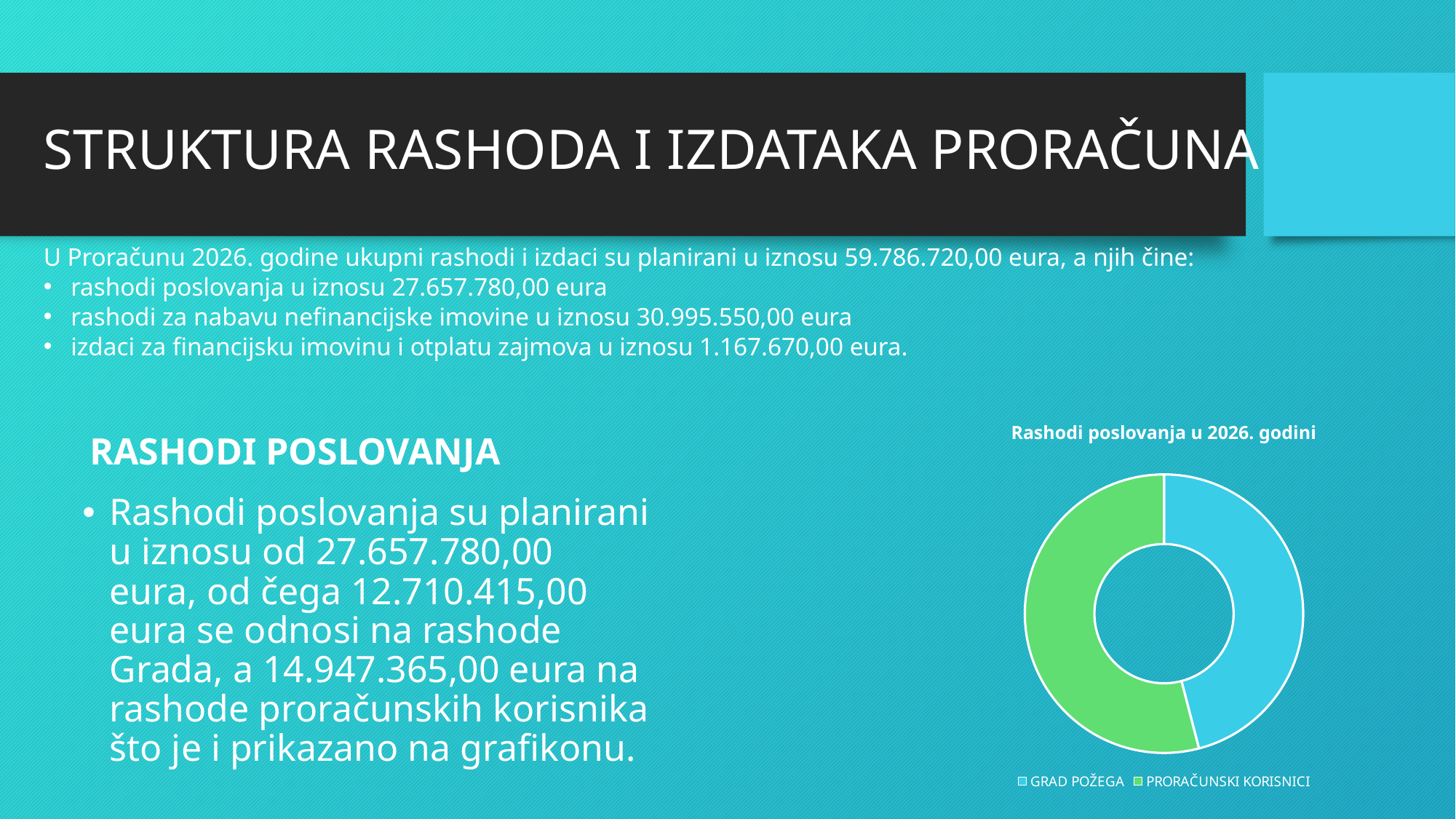
What kind of chart is shown on the slide? Doughnut chart How many entries does the chart legend list? 2 Which category has the larger share of the doughnut chart? PRORAČUNSKI KORISNICI Is the share for GRAD POŽEGA larger or smaller than the share for PRORAČUNSKI KORISNICI? smaller Which colour represents GRAD POŽEGA in the chart? Blue What is the difference between the amounts for PRORAČUNSKI KORISNICI and GRAD POŽEGA shown in the chart? 2.236.950,00 eura How many categories does the doughnut chart show? 2 What is the title of the chart on the slide? Rashodi poslovanja u 2026. godini Which category has the smaller share of the doughnut chart? GRAD POŽEGA According to the slide, what amount of rashodi poslovanja is attributed to PRORAČUNSKI KORISNICI in the chart? 14.947.365,00 eura According to the slide, what amount of rashodi poslovanja is attributed to GRAD POŽEGA in the chart? 12.710.415,00 eura What is the total of the two amounts represented in the doughnut chart? 27.657.780,00 eura